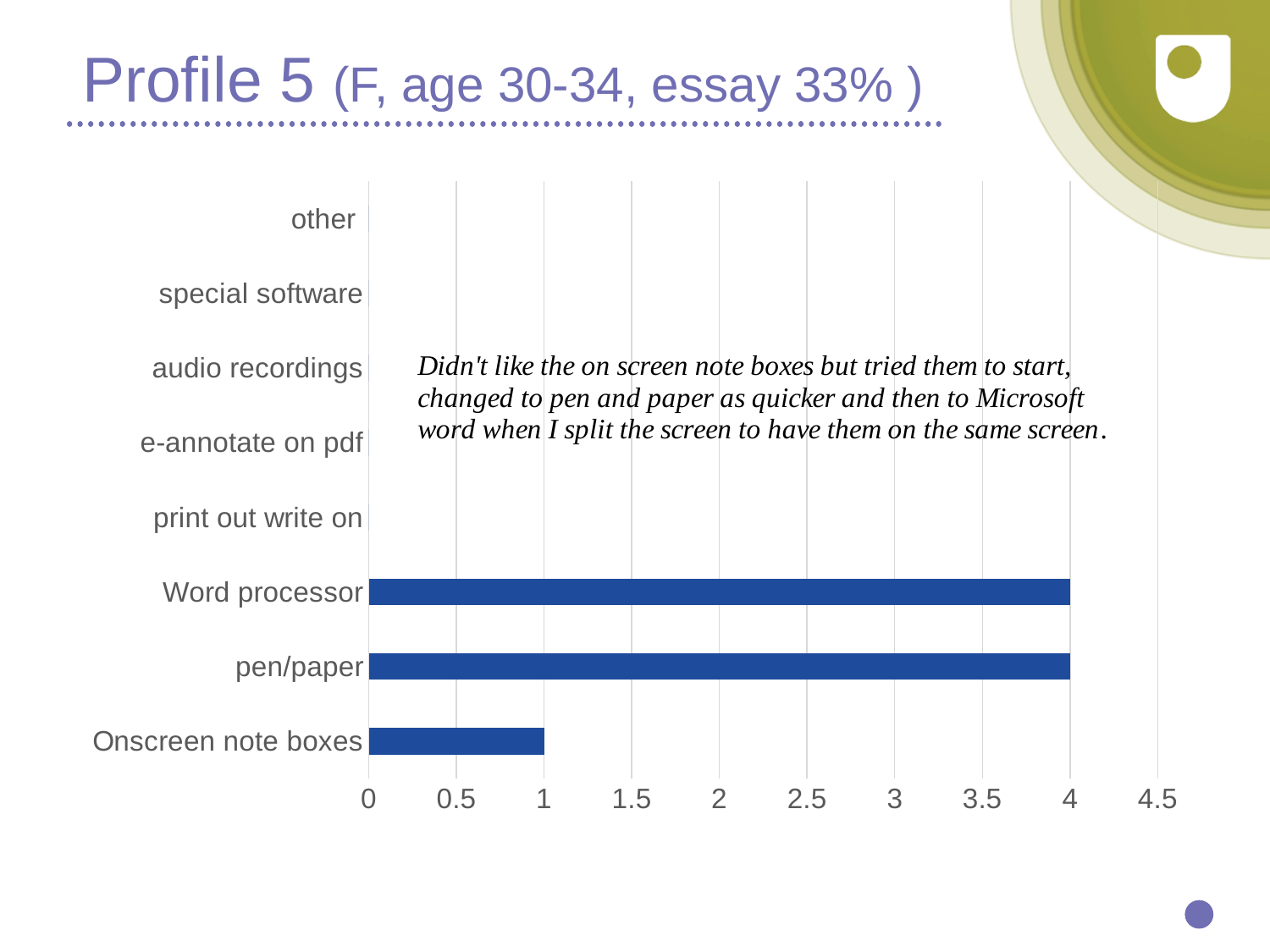
What is the value for Onscreen note boxes? 1 How many categories are listed on the vertical axis of the chart? 8 Which is larger, the value for pen/paper or the value for Onscreen note boxes? pen/paper Is the value for Onscreen note boxes greater or less than 2? less What is the difference between the value for Word processor and the value for Onscreen note boxes? 3 Which is larger, the value for Word processor or the value for Onscreen note boxes? Word processor What kind of chart is shown on the slide? bar chart What is the value for pen/paper? 4 What is the value for Word processor? 4 What is the highest tick value shown on the horizontal axis? 4.5 Is the value for pen/paper greater or less than 3? greater Which category is listed at the top of the vertical axis? other